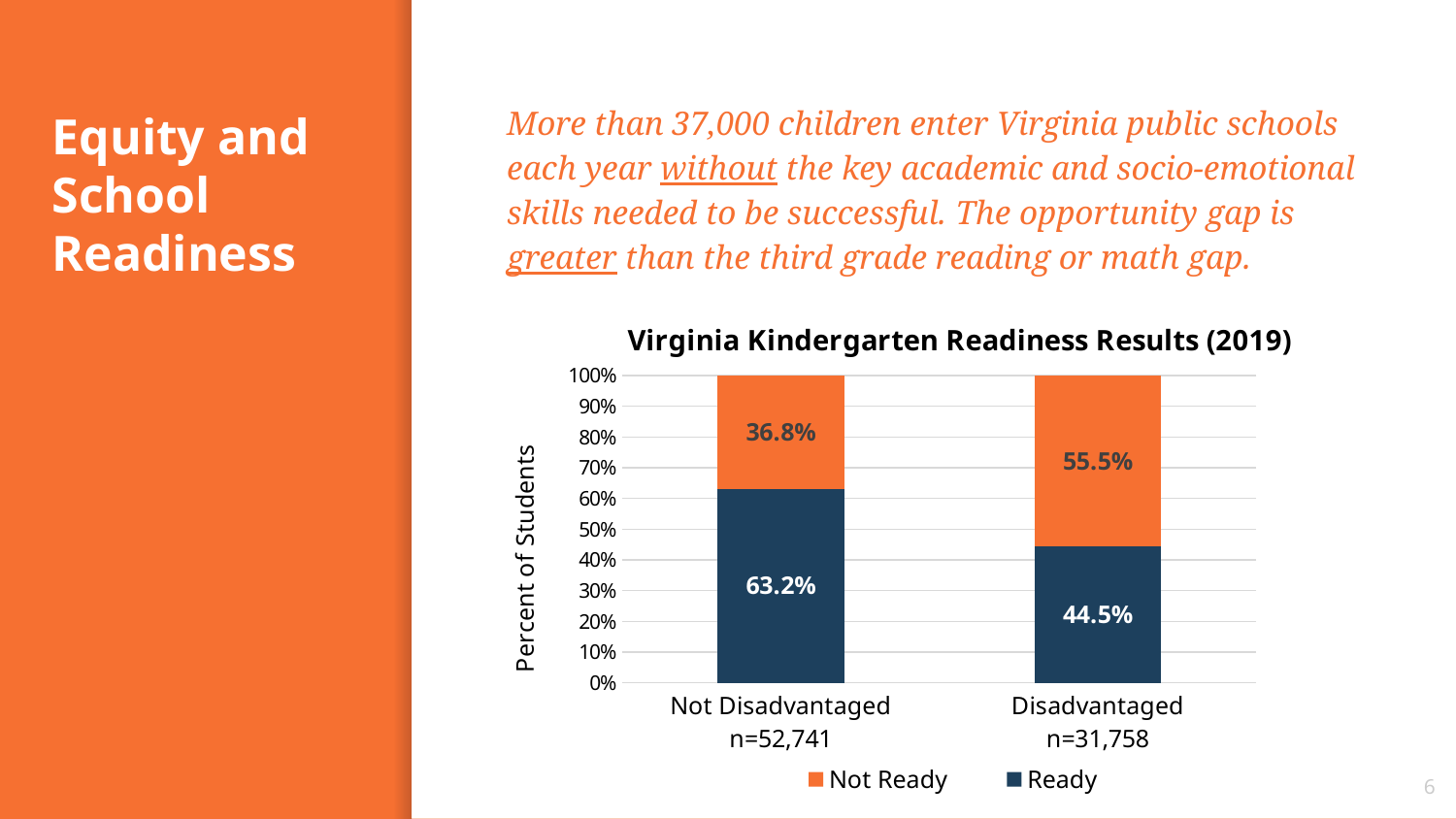
How many series does the legend list? 2 What is the difference in the Ready percentage between Not Disadvantaged and Disadvantaged students? 18.7% What percentage of Not Disadvantaged students are Ready? 63.2% What percentage of Not Disadvantaged students are Not Ready? 36.8% Is the Not Ready percentage larger for Disadvantaged or Not Disadvantaged students? Disadvantaged How many student groups are shown on the x axis? 2 What is the title of the chart? Virginia Kindergarten Readiness Results (2019) What percentage of Disadvantaged students are Ready? 44.5% Which group has the higher Ready percentage? Not Disadvantaged Which group has the lower Not Ready percentage? Not Disadvantaged What percentage of Disadvantaged students are Not Ready? 55.5% What type of chart is shown? Stacked bar chart